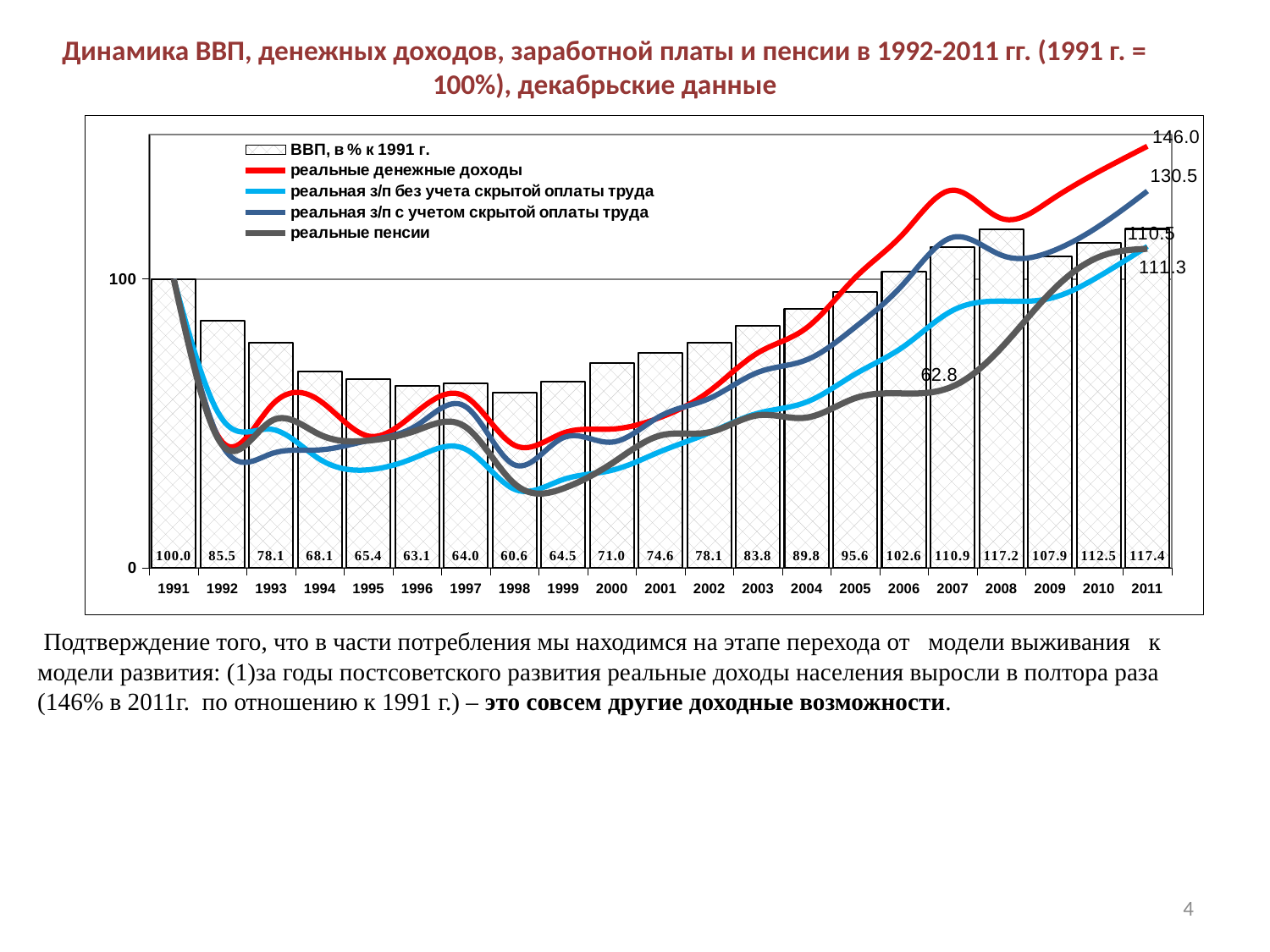
What is the value of ВВП, в % к 1991 г. for 2008? 117.2 In which year is the ВВП bar the lowest? 1998 Do the ВВП bars rise or fall from 1991 to 1998? Fall What is the value of реальная з/п с учетом скрытой оплаты труда in 2011? 130.5 What is the difference between the ВВП values for 2011 and 1991? 17.4 What is the value of реальные денежные доходы in 2011? 146.0 How many series does the legend list? 5 How many years are shown on the x axis? 21 Which year has the higher ВВП value, 2009 or 2010? 2010 What kind of chart is shown on the slide? Combined bar and line chart What is the value of ВВП, в % к 1991 г. for 1998? 60.6 Is the value of реальные пенсии in 2000 greater or less than 100? less